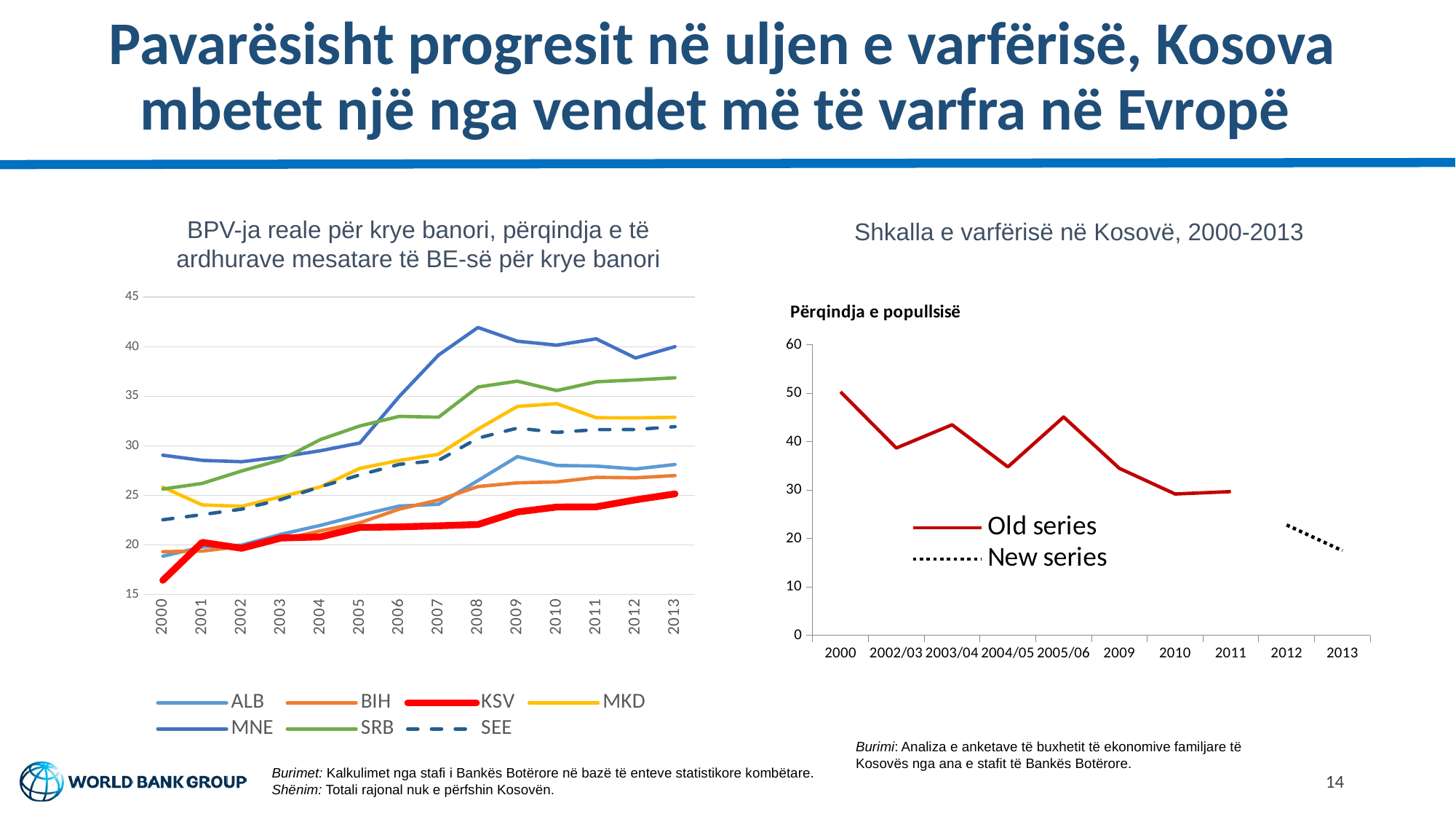
On the left chart, which series has the lowest value in 2013? KSV On the left chart, which series is drawn as a dashed line? SEE On the left chart, does the KSV line generally rise or fall from 2000 to 2013? rise On the left chart, which series has the highest value in 2013? MNE On the right chart, is the Old series value in 2000 greater or less than 40? greater What kind of chart is the left chart, 'BPV-ja reale për krye banori'? line chart On the right chart, 'Shkalla e varfërisë në Kosovë, 2000-2013', how many series does the legend list? 2 On the left chart, how many series does the legend list? 7 On the left chart, is the value for KSV in 2013 greater or less than 30? less On the left chart, how many years are shown on the x axis? 14 On the right chart, does the Old series generally rise or fall from 2000 to 2011? fall On the left chart, is the value for MNE in 2008 greater or less than 40? greater